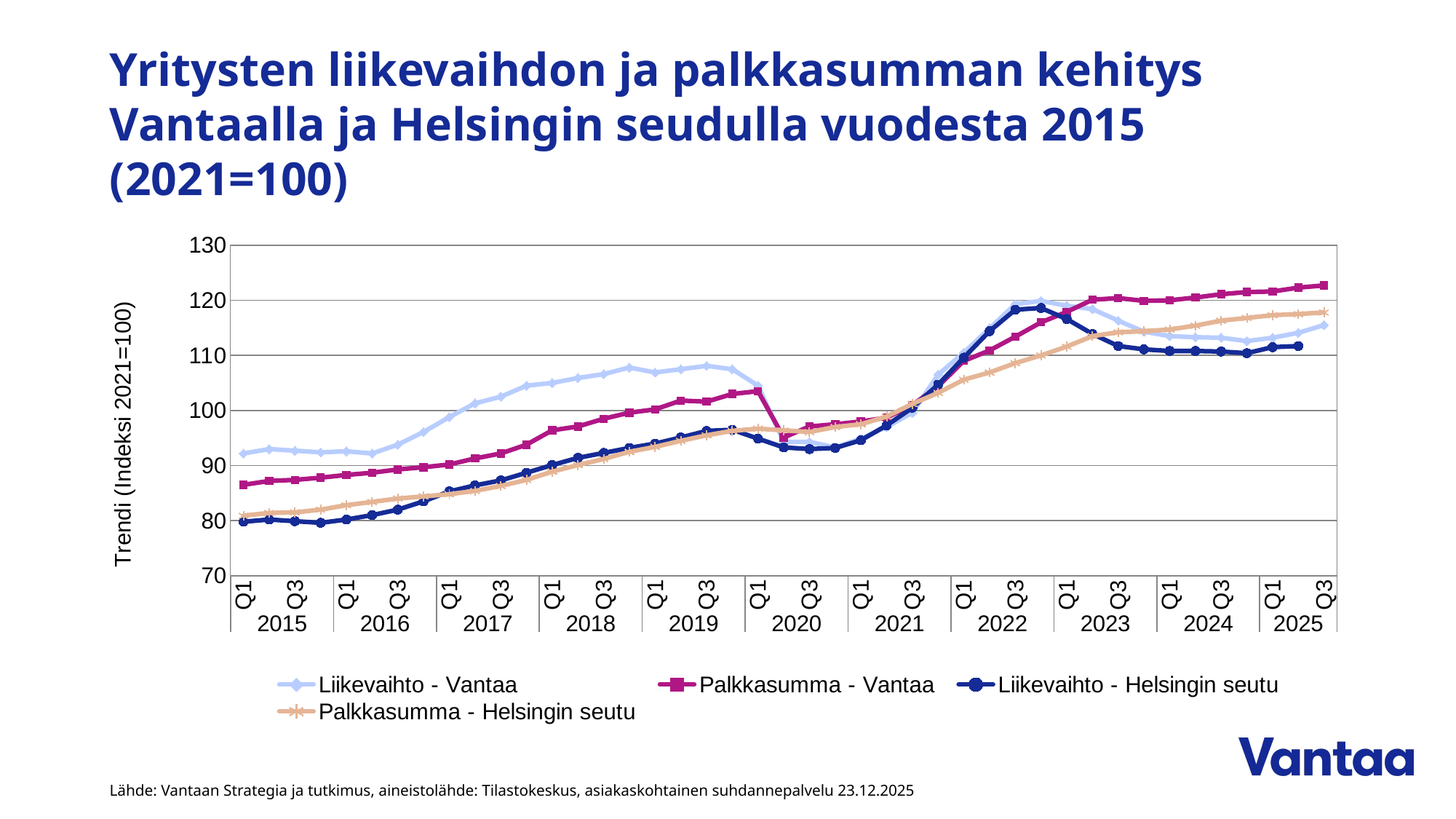
Which series is represented by the magenta line with square markers? Palkkasumma - Vantaa What is the label of the vertical axis? Trendi (Indeksi 2021=100) At Q1 2015, which is higher: Liikevaihto - Vantaa or Liikevaihto - Helsingin seutu? Liikevaihto - Vantaa Does the Palkkasumma - Vantaa series overall rise or fall from 2015 to 2025? rise Is the value for Palkkasumma - Vantaa at Q1 2015 greater or less than 90? less How many series does the legend list? 4 Is the value for Liikevaihto - Helsingin seutu at Q1 2015 greater or less than 90? less Is the value for Palkkasumma - Vantaa at Q3 2025 greater or less than 120? greater Which series has the highest value at Q3 2025? Palkkasumma - Vantaa What kind of chart is shown on the slide? line chart